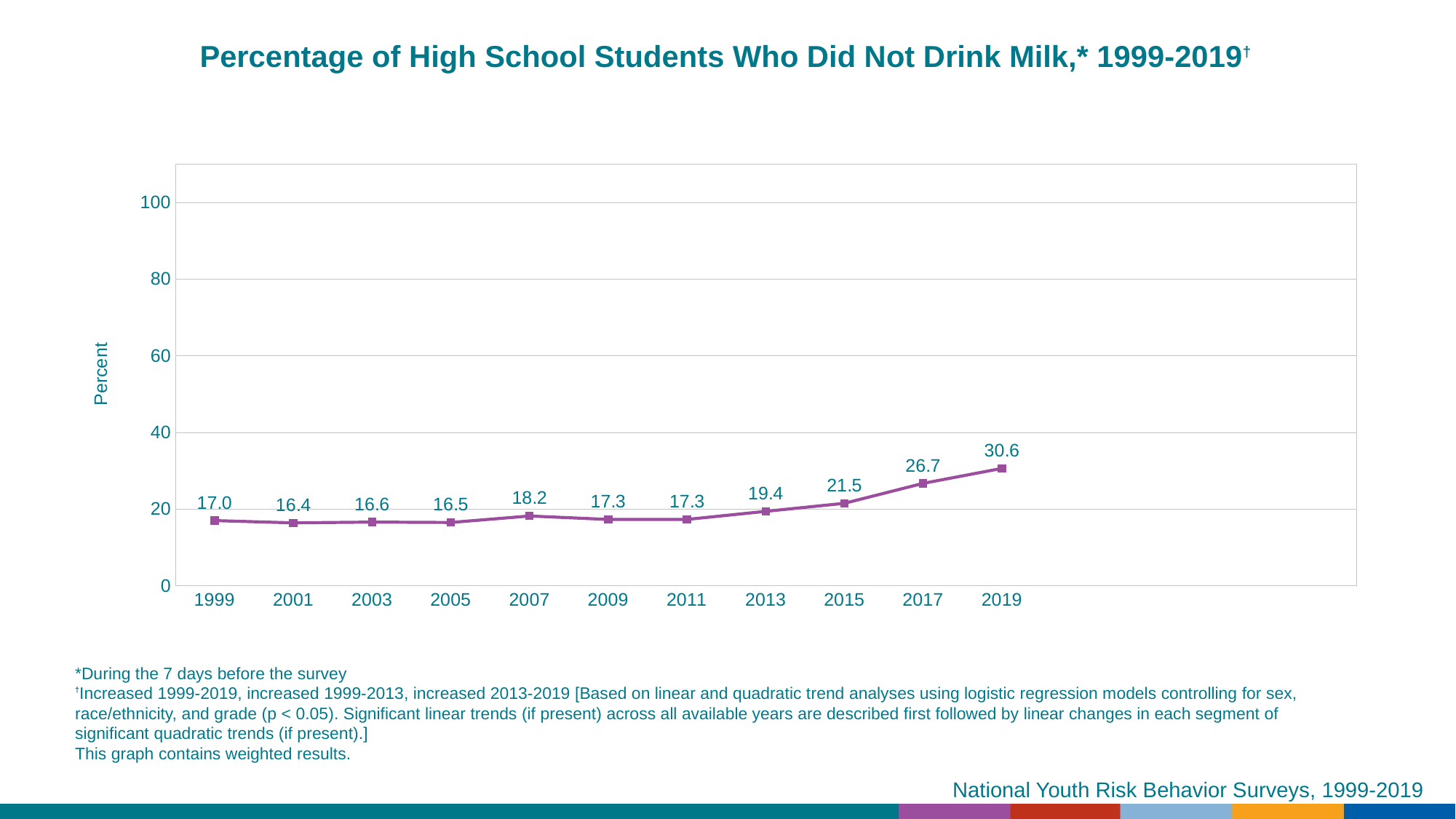
What was the value for 2013? 19.4 What is the difference between the 2019 value and the 1999 value? 13.6 What percentage of high school students did not drink milk in 2019? 30.6 Which year has a larger value, 2007 or 2015? 2015 What is the difference between the 2019 value and the 2017 value? 3.9 How many years are plotted on the chart? 11 What kind of chart is shown on the slide? line chart Which year has the highest percentage of students who did not drink milk? 2019 What was the value for 1999? 17.0 Which year has the lowest percentage of students who did not drink milk? 2001 What is the label on the y axis? Percent Is the value for 2019 greater or less than 40? less